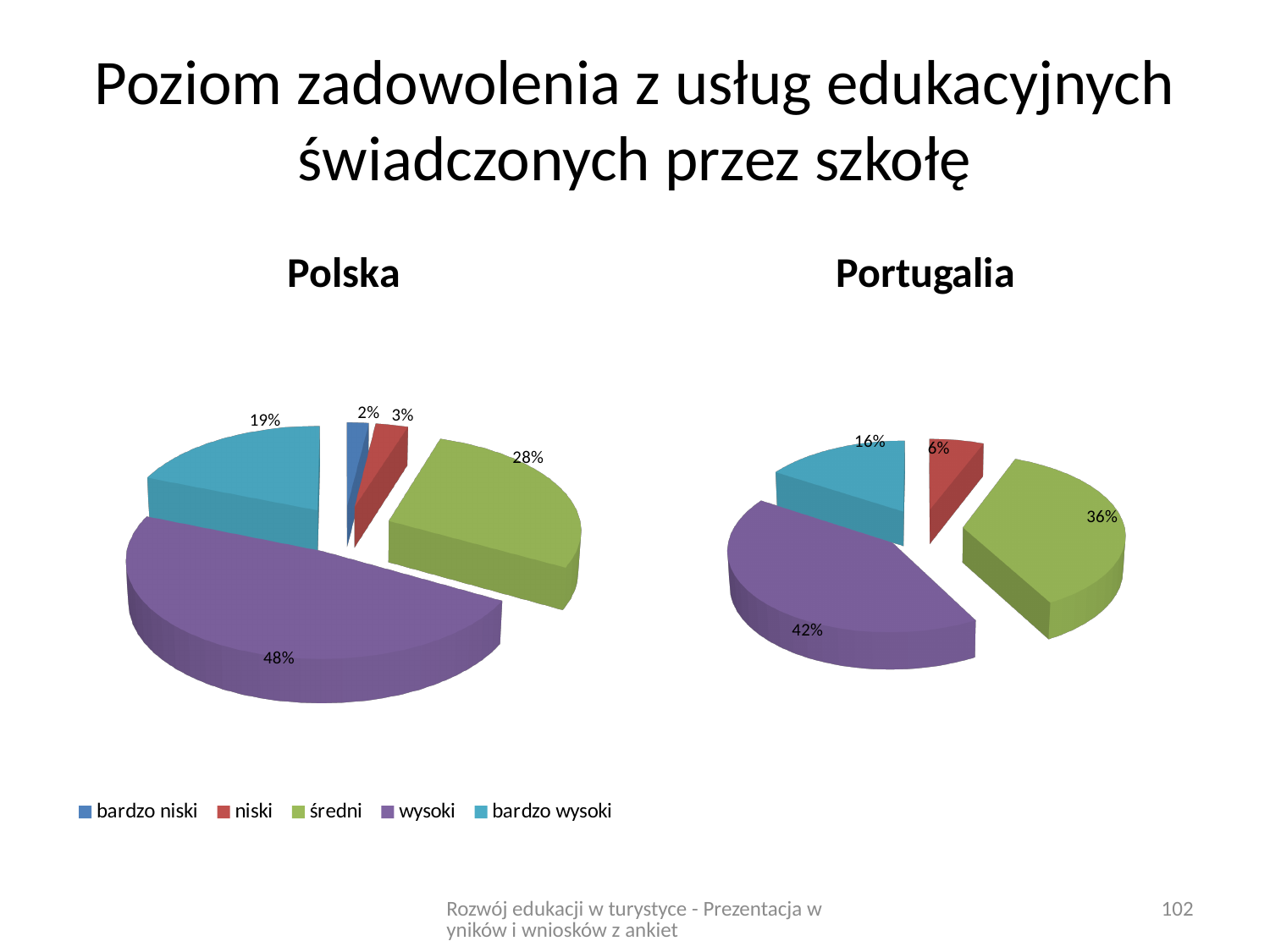
In the Portugalia chart, which category has the smallest visible slice? niski What is the difference between the "wysoki" share in the Polska chart and the "wysoki" share in the Portugalia chart? 6% How many slices are visible in the Polska chart? 5 In the Polska chart, which category has the largest slice? wysoki Which chart shows a larger share for "średni", Polska or Portugalia? Portugalia In the Portugalia chart, what percentage is shown for the "średni" slice? 36% How many categories does the legend list? 5 In the Portugalia chart, what percentage is shown for the "niski" slice? 6% What type of chart is used for Polska and Portugalia? Pie chart In the Polska chart, what percentage is shown for the "wysoki" slice? 48% In the Polska chart, which category has the smallest slice? bardzo niski In the Polska chart, what percentage is shown for the "bardzo wysoki" slice? 19%